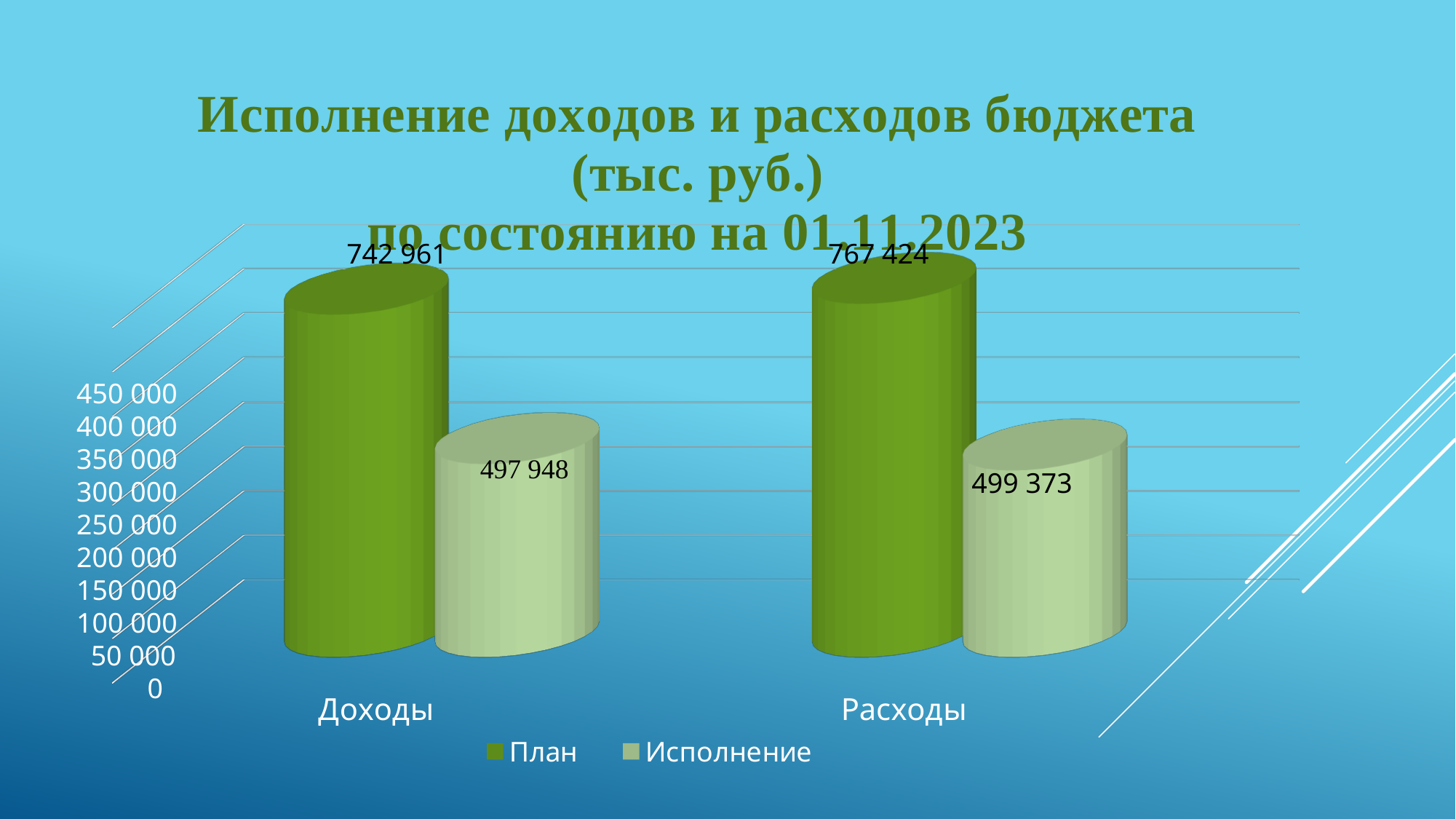
How many series does the legend list? 2 What is the difference between План and Исполнение for Расходы? 268 051 Is the Исполнение value for Расходы greater or less than 400 000? greater What is the План value for Расходы? 767 424 What is the План value for Доходы? 742 961 Which bar has the highest value on the chart? План for Расходы What is the difference between План and Исполнение for Доходы? 245 013 Which is larger, the План value for Доходы or the План value for Расходы? План for Расходы What is the Исполнение value for Расходы? 499 373 What kind of chart is shown on the slide? Bar chart What is the Исполнение value for Доходы? 497 948 Which bar has the lowest value on the chart? Исполнение for Доходы